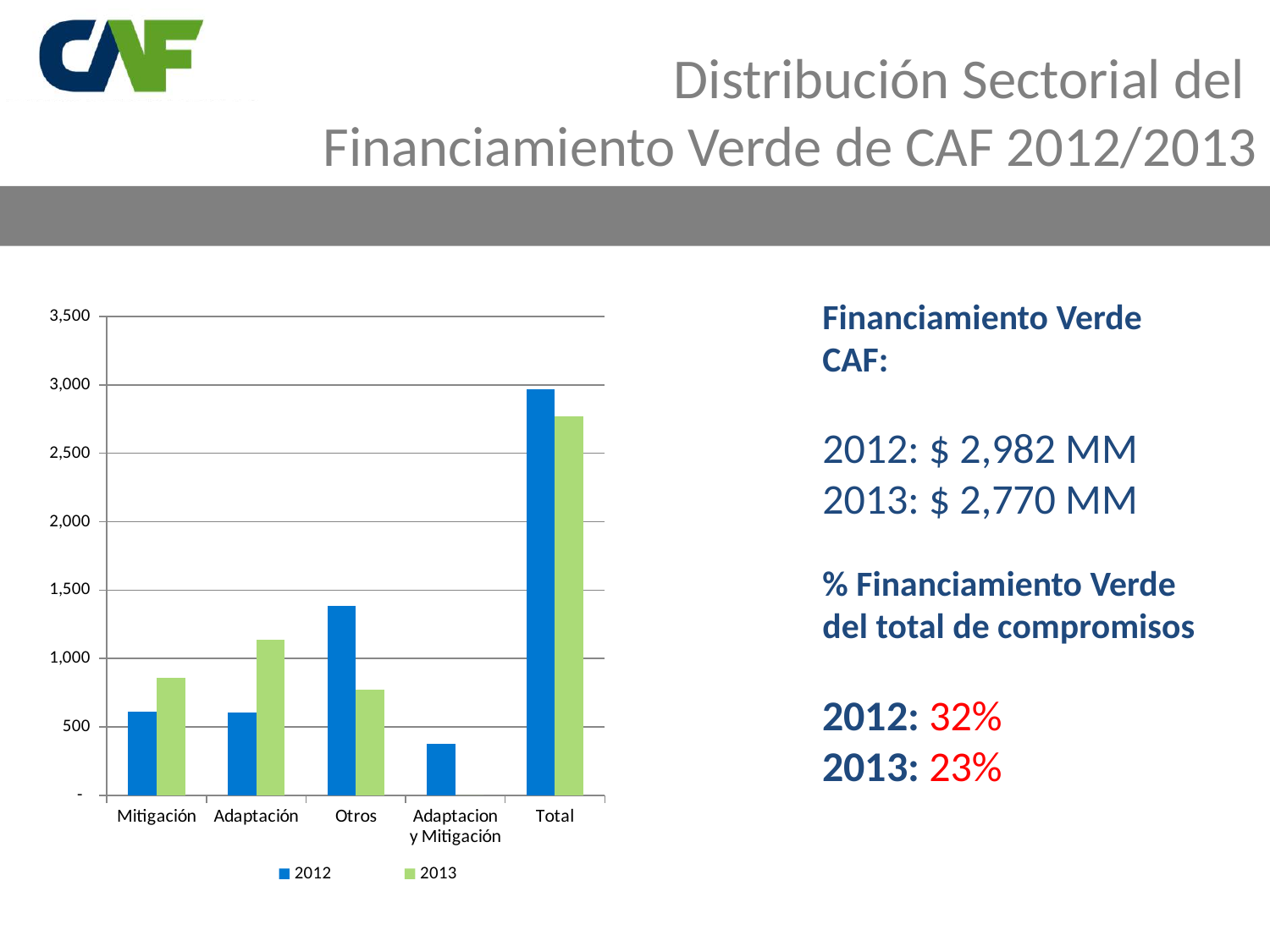
Is the 2012 value for Total greater or less than 2,500? greater For Adaptación, which series has the larger value, 2012 or 2013? 2013 For Otros, which series has the larger value, 2012 or 2013? 2012 Which category has the highest 2012 value in the chart? Total Is the 2013 value for Otros greater or less than 1,000? less How many categories are shown on the x axis of the chart? 5 Is the 2012 value for Otros greater or less than 1,000? greater What kind of chart is shown on the slide? bar chart Which colour represents the 2013 series in the chart? green Which category has the lowest 2012 value in the chart? Adaptacion y Mitigación How many series does the chart legend list? 2